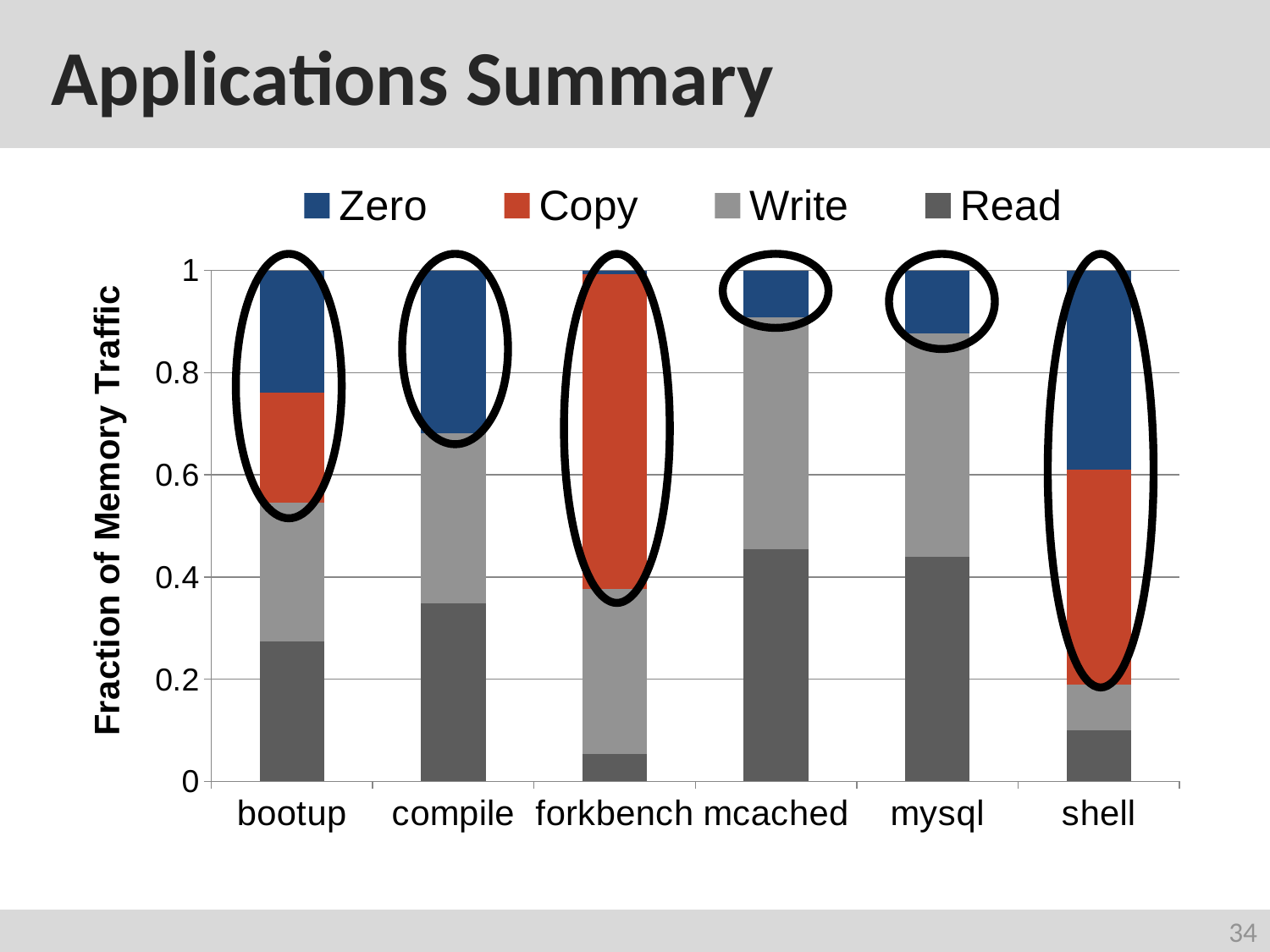
Which application has the smallest Read segment? forkbench What is the label of the y axis? Fraction of Memory Traffic Which application has the largest Copy segment? forkbench What kind of chart is shown on the slide? stacked bar chart Is the Read fraction for shell greater or less than 0.2? less How many series does the legend list? 4 Which has the larger Write segment, bootup or shell? bootup Which has the larger Read segment, compile or bootup? compile How many applications (categories) are shown on the x axis? 6 Is the Read fraction for mcached greater or less than 0.4? greater Which application has the largest Zero segment? shell Is the Copy fraction for forkbench greater or less than 0.4? greater